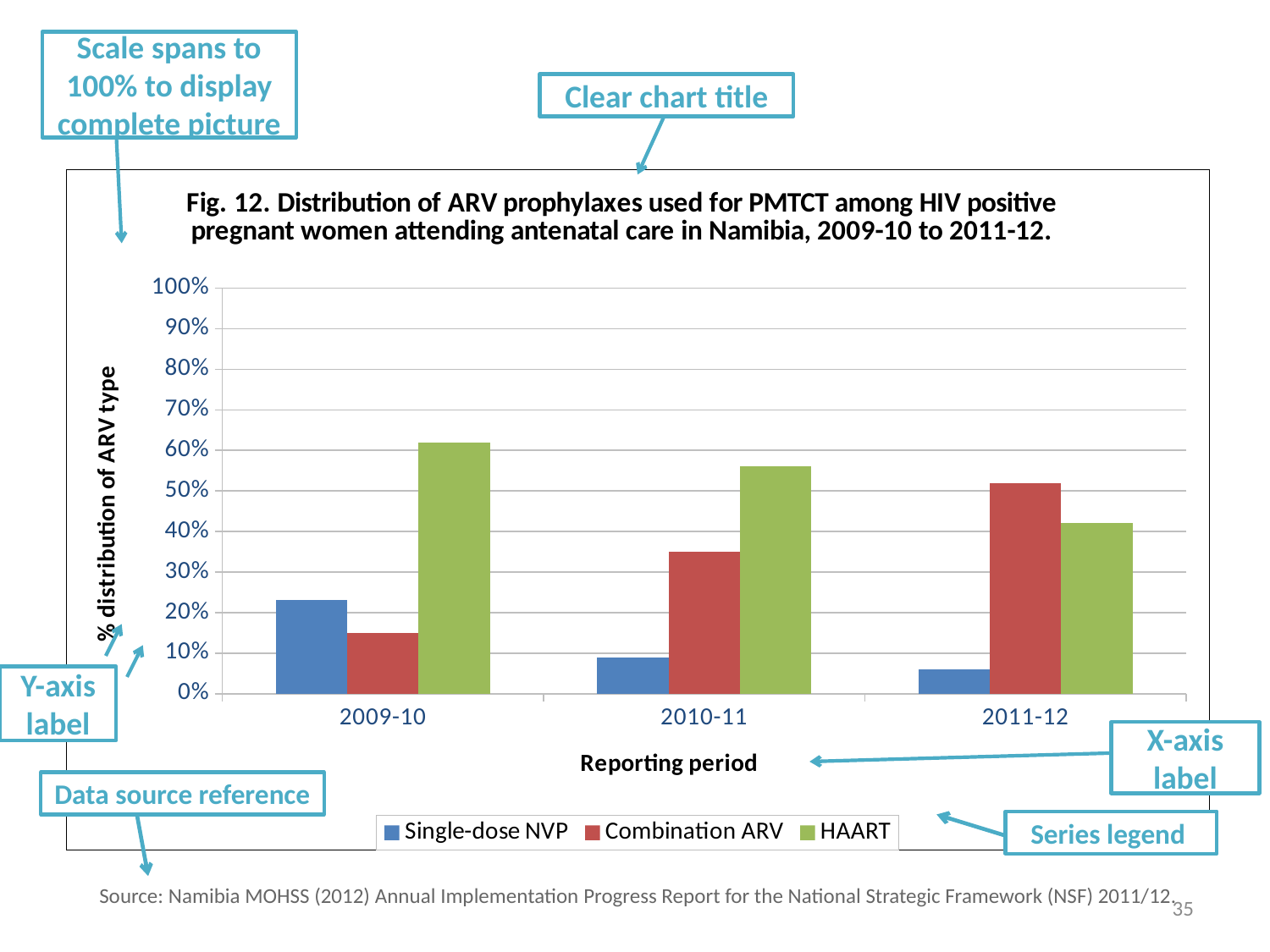
What is the label on the x axis of the chart? Reporting period Is the value for Combination ARV in 2010-11 greater or less than 30%? greater Which ARV type has the highest value in 2011-12? Combination ARV Which is larger in 2010-11, Combination ARV or Single-dose NVP? Combination ARV Does the value for Single-dose NVP rise or fall from 2009-10 to 2011-12? fall What kind of chart is shown on the slide? bar chart Is the value for HAART in 2009-10 greater or less than 60%? greater Is the value for Single-dose NVP in 2011-12 greater or less than 10%? less How many reporting periods are shown on the x axis? 3 Which ARV type has the highest value in 2009-10? HAART How many series does the legend list? 3 Which ARV type has the lowest value in 2011-12? Single-dose NVP